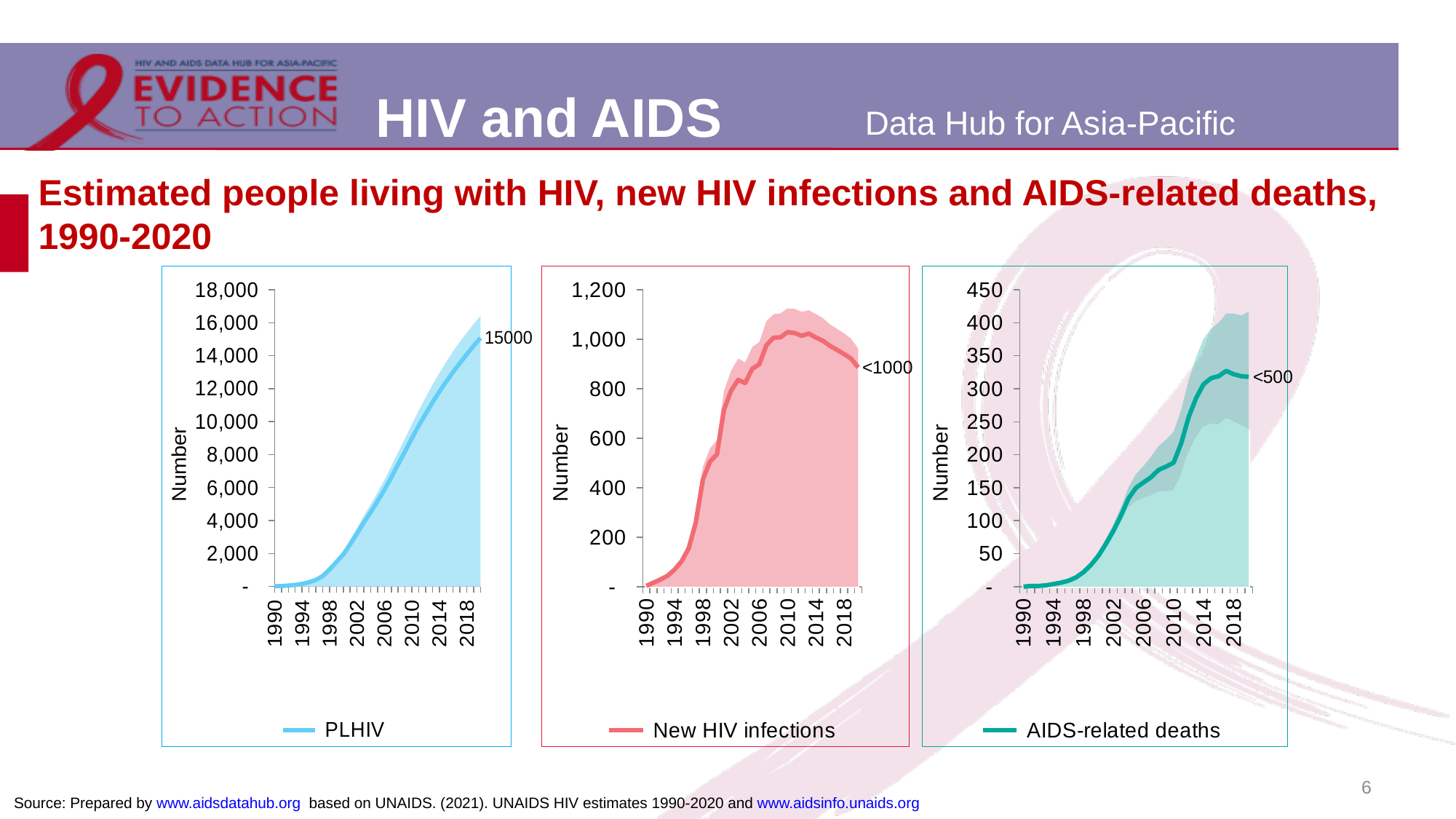
What kind of chart is the PLHIV chart on the left? Area and line chart (a line with a shaded area band) How many series does the legend of the New HIV infections chart (middle) list? 1 On the New HIV infections chart (middle), is the value for 1994 greater or less than 200? less On the New HIV infections chart (middle), does the line rise or fall between 2012 and 2020? Fall On the AIDS-related deaths chart (right), is the value for 2002 greater or less than 150? less On the PLHIV chart (left), what value is labelled at the end of the line in 2020? 15000 How many charts are shown on the slide? 3 On the PLHIV chart (left), does the number of people living with HIV rise or fall from 1990 to 2020? Rise On the New HIV infections chart (middle), what value is labelled at the end of the line in 2020? <1000 What is the legend entry of the chart on the right? AIDS-related deaths On the AIDS-related deaths chart (right), what value is labelled at the end of the line in 2020? <500 On the PLHIV chart (left), is the value for 2014 greater or less than 10,000? greater